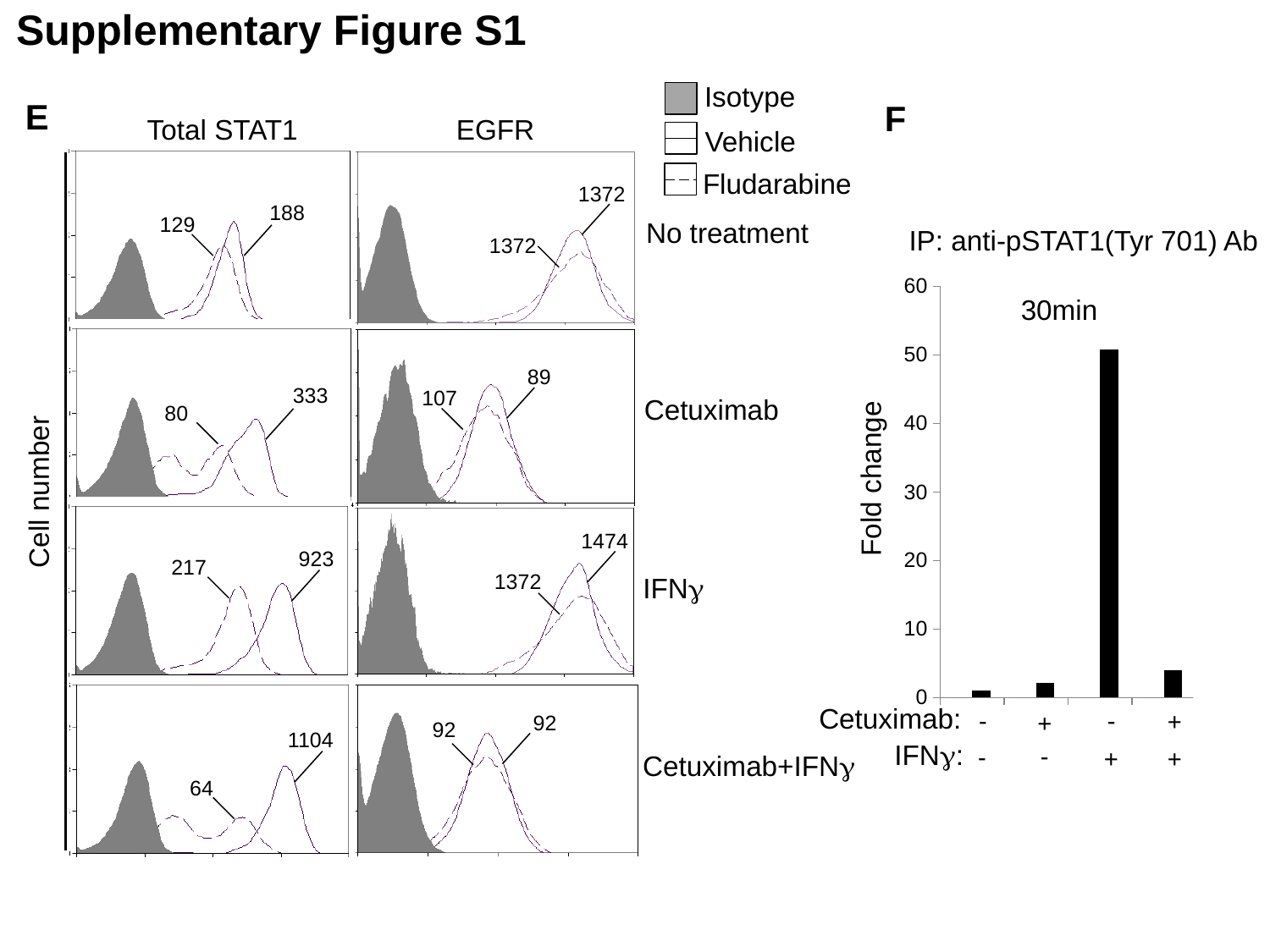
How many entries does the legend for panel E list? 3 What is the y-axis label of the panel F bar chart? Fold change In panel E, what is the larger labeled value in the EGFR histogram for the IFNγ treatment? 1474 In panel F, which has the larger fold change: the IFNγ-only condition or the Cetuximab+IFNγ condition? IFNγ-only condition What kind of chart is panel F? bar chart In panel F, which treatment condition has the lowest fold change? Cetuximab -, IFNγ - In panel F, is the fold change for the IFNγ-only condition (Cetuximab -, IFNγ +) greater or less than 40? greater In panel E, what is the larger labeled value in the Total STAT1 histogram for the Cetuximab+IFNγ treatment? 1104 How many bars are plotted in the panel F bar chart? 4 What is the maximum value shown on the y-axis of the panel F bar chart? 60 In panel F, is the fold change for the Cetuximab+IFNγ condition (Cetuximab +, IFNγ +) greater or less than 10? less In panel F, which treatment condition has the highest fold change? Cetuximab -, IFNγ +